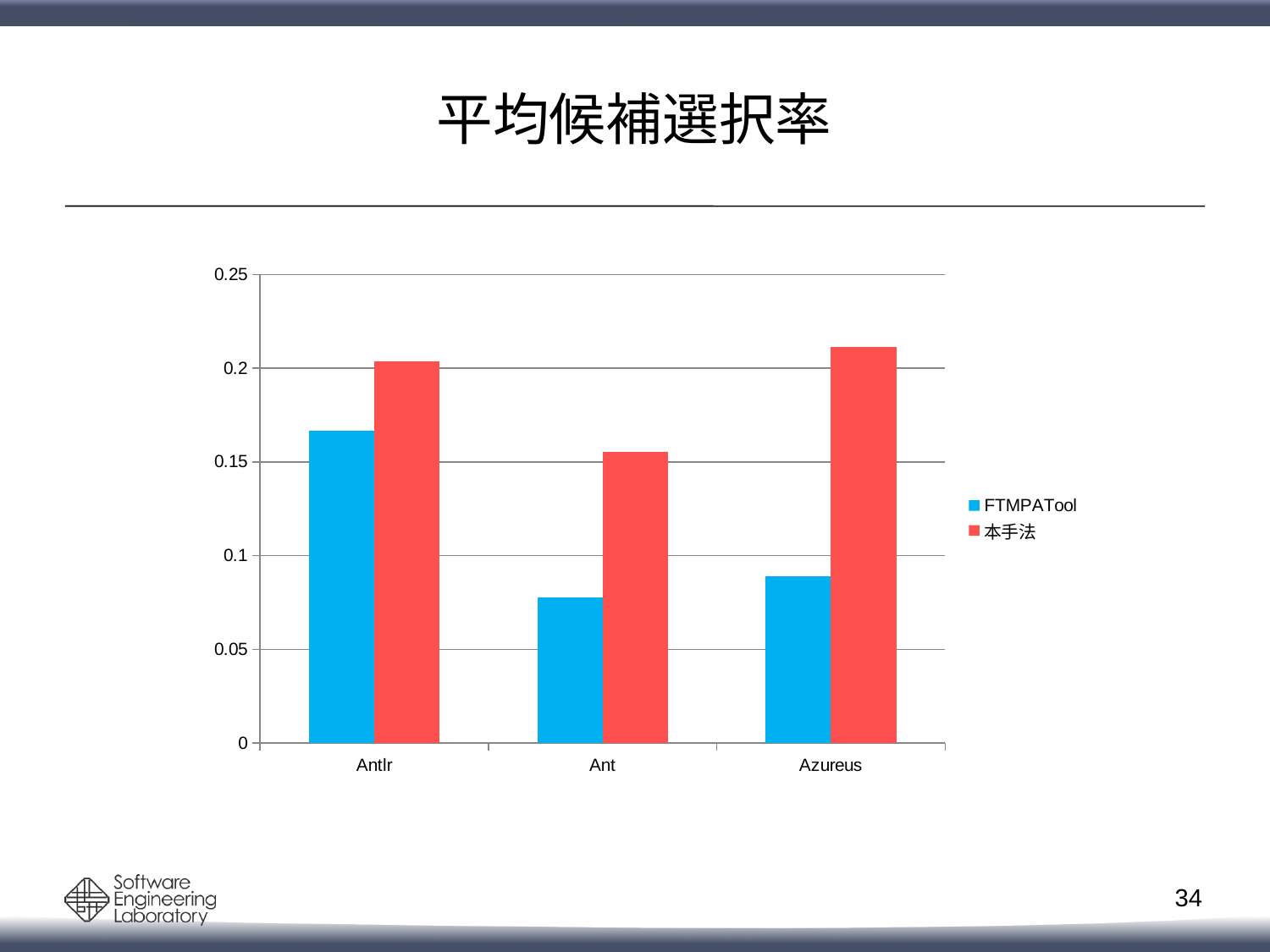
Is the value for 本手法 at Azureus greater or less than 0.2? greater How many series does the legend list? 2 For Ant, which series has the larger value, FTMPATool or 本手法? 本手法 Which category has the highest value for FTMPATool? Antlr Which category has the lowest value for FTMPATool? Ant What is the title of the slide? 平均候補選択率 Which category has the highest value for 本手法? Azureus Is the value for FTMPATool at Antlr greater or less than 0.15? greater What kind of chart is shown on the slide? bar chart How many categories are shown on the x axis? 3 Which category has the lowest value for 本手法? Ant Is the value for FTMPATool at Azureus greater or less than 0.1? less